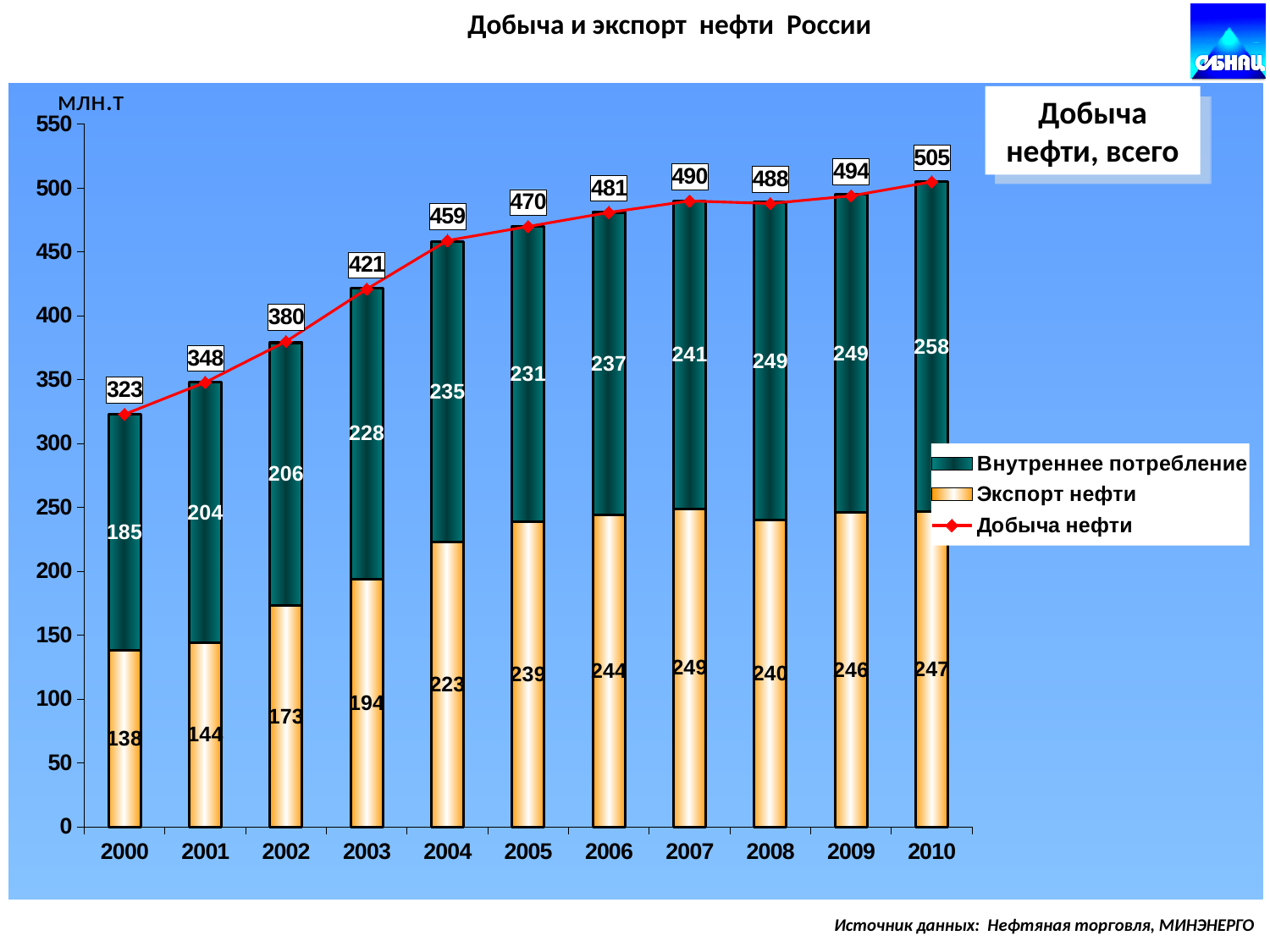
Which year has the highest value of Добыча нефти? 2010 What is the value of Добыча нефти for 2007? 490 What is the value of Внутреннее потребление for 2010? 258 What is the total of the stacked bar for 2003 (Экспорт нефти plus Внутреннее потребление)? 422 What is the difference between Добыча нефти in 2010 and in 2000? 182 Which year has the lowest value of Экспорт нефти? 2000 How many series does the legend list? 3 Which is larger in 2008: Экспорт нефти or Внутреннее потребление? Внутреннее потребление Does Добыча нефти generally rise or fall from 2000 to 2010? Rise What is the value of Экспорт нефти for 2004? 223 What kind of chart is shown on the slide? Stacked bar chart with a line How many years are shown on the x axis? 11